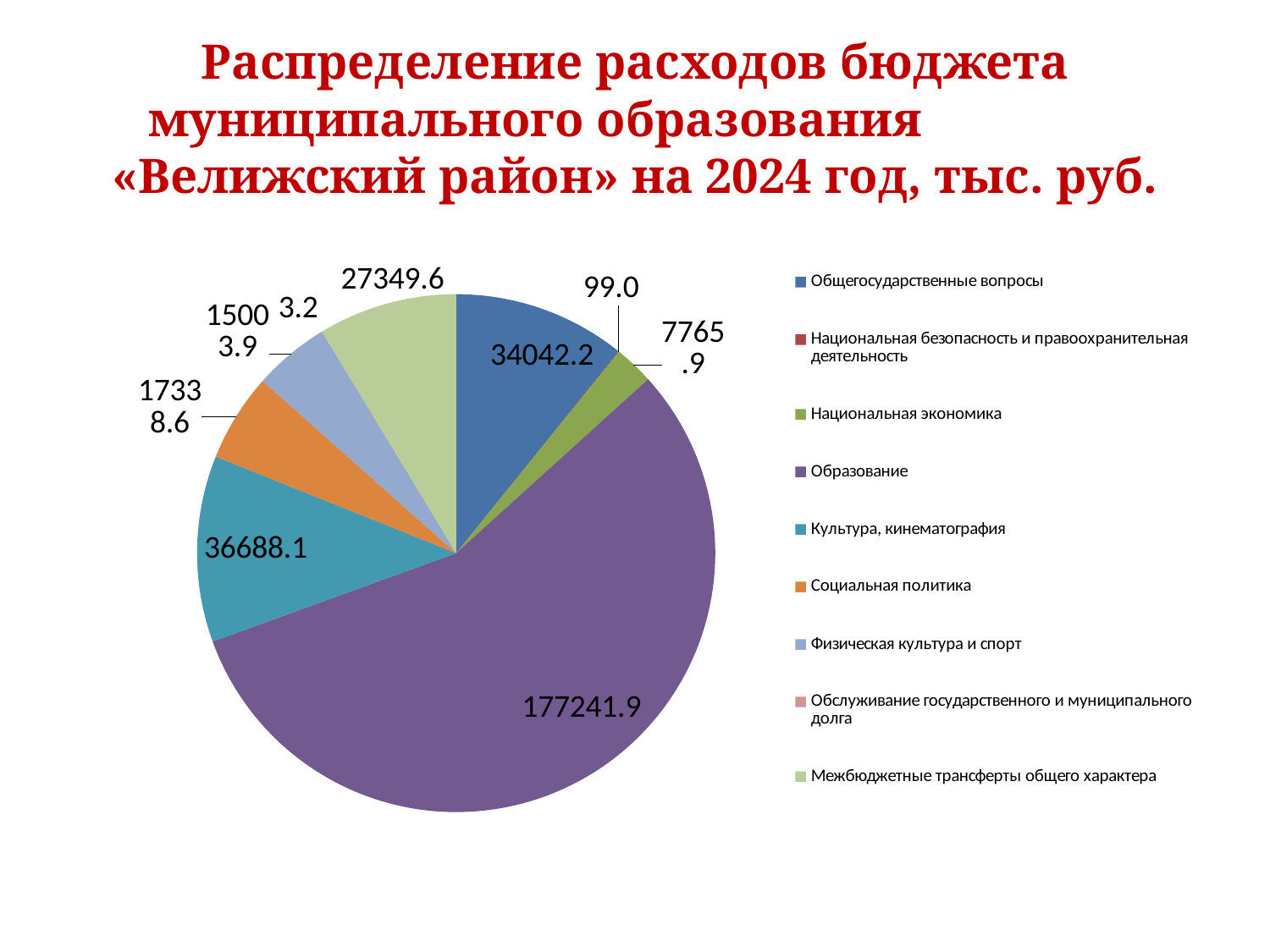
Which is larger: the value for Межбюджетные трансферты общего характера or the value for Социальная политика? Межбюджетные трансферты общего характера What is the value for Межбюджетные трансферты общего характера? 27349.6 Which category has the largest slice of the pie? Образование What is the value for Общегосударственные вопросы? 34042.2 What colour is the slice for Образование? purple Which category has the smallest value? Обслуживание государственного и муниципального долга What is the value for Образование? 177241.9 What is the difference between the values for Культура, кинематография and Общегосударственные вопросы? 2645.9 What is the value for Национальная безопасность и правоохранительная деятельность? 99.0 What is the value for Культура, кинематография? 36688.1 How many categories does the legend list? 9 What type of chart is shown on the slide? pie chart